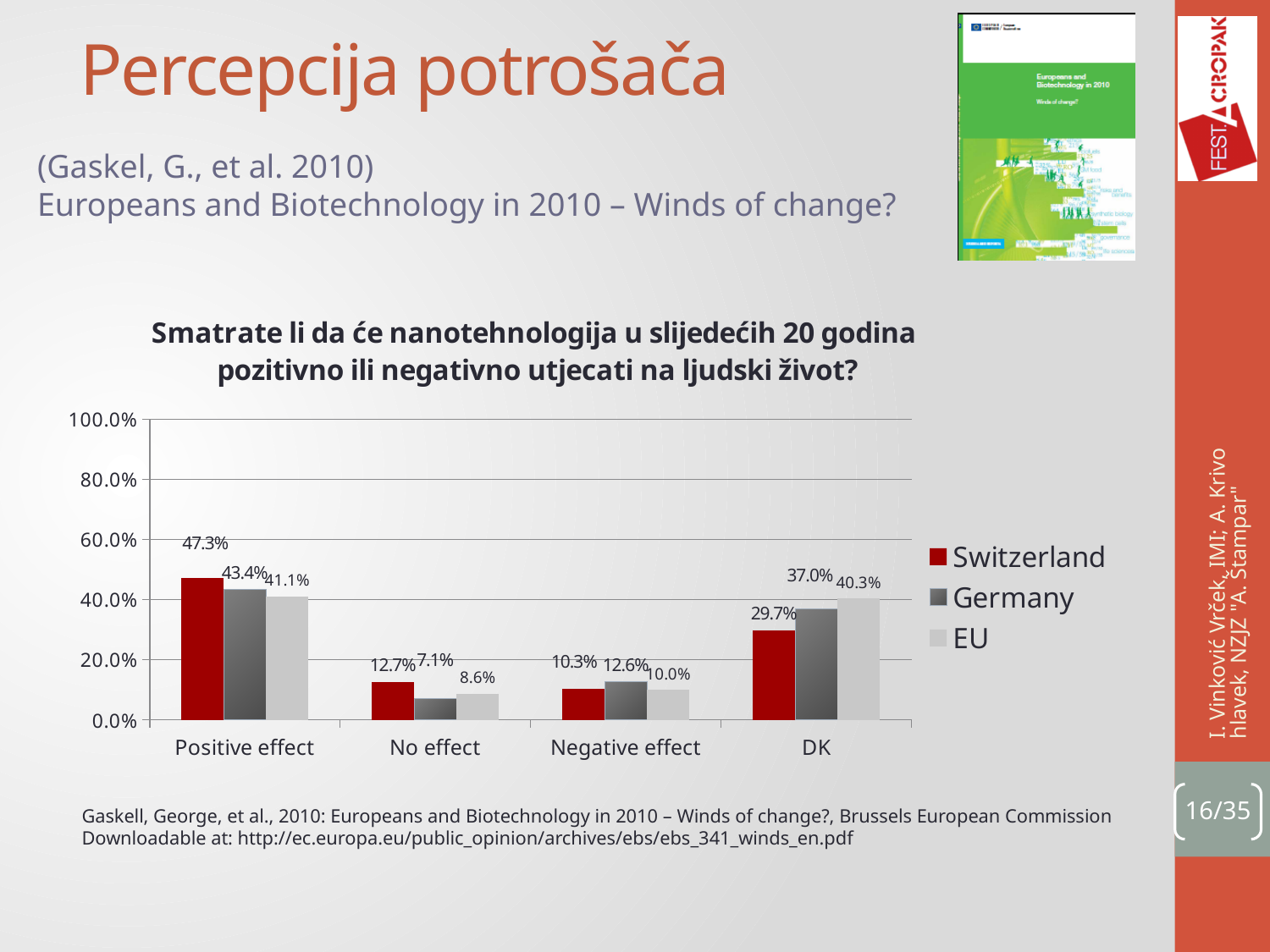
Which category has the lowest value for Germany? No effect In the DK category, which is larger: the value for Switzerland or the value for Germany? Germany What is the value for Switzerland in the Positive effect category? 47.3% What is the value for Germany in the Negative effect category? 12.6% How many series does the legend list? 3 What kind of chart is shown on the slide? Bar chart Which category has the highest value for Switzerland? Positive effect What is the value for EU in the DK category? 40.3% What is the difference between the Switzerland and EU values in the Positive effect category? 6.2% Which series is shown in red in the legend? Switzerland What is the value for Germany in the No effect category? 7.1% How many categories are shown on the x axis? 4